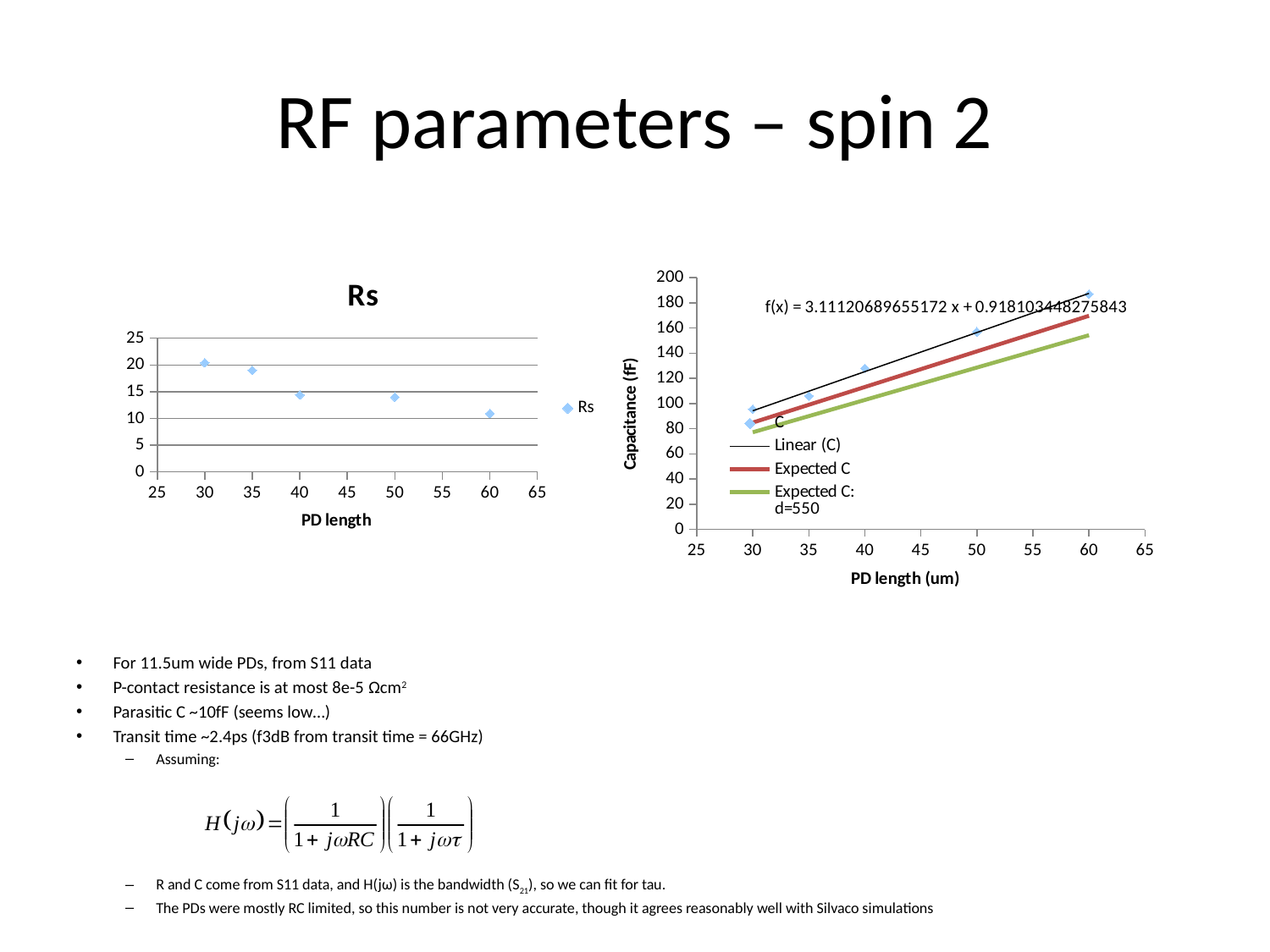
In the Rs chart on the left, at which PD length is Rs lowest? 60 In the Rs chart on the left, how many data points are plotted? 5 In the capacitance chart on the right, what is the y-axis label? Capacitance (fF) In the capacitance chart on the right, is the measured C value at PD length 50 greater or less than 140? greater In the capacitance chart on the right, what is the trendline equation shown? f(x) = 3.11120689655172 x + 0.918103448275843 In the capacitance chart on the right, is the measured C value at PD length 60 greater or less than 180? greater In the Rs chart on the left, what kind of chart is it? scatter chart In the Rs chart on the left, at which PD length is Rs highest? 30 In the capacitance chart on the right, how many entries does the legend list? 4 In the Rs chart on the left, do the Rs values rise or fall as PD length increases? fall